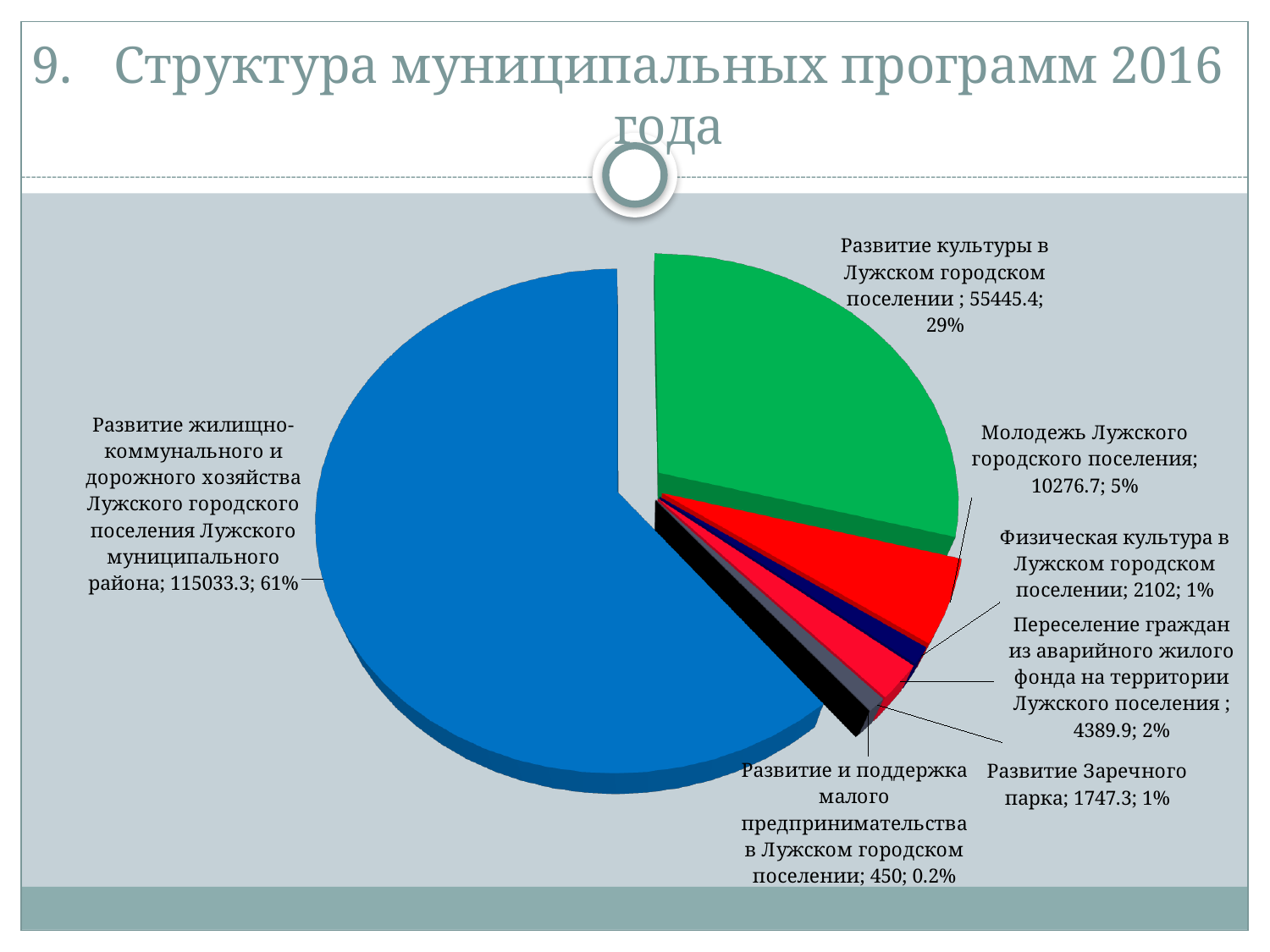
What kind of chart is shown on the slide? Pie chart What is the value for "Физическая культура в Лужском городском поселении"? 2102 What is the value for "Развитие Заречного парка"? 1747.3 Which program has the largest slice of the pie? Развитие жилищно-коммунального и дорожного хозяйства Лужского городского поселения Лужского муниципального района What share of the pie does "Развитие жилищно-коммунального и дорожного хозяйства" represent? 61% What is the value for "Развитие культуры в Лужском городском поселении"? 55445.4 Which is larger: the value for "Молодежь Лужского городского поселения" or for "Переселение граждан из аварийного жилого фонда"? Молодежь Лужского городского поселения What is the difference between the values for "Переселение граждан из аварийного жилого фонда" and "Физическая культура в Лужском городском поселении"? 2287.9 What is the title of the slide containing the chart? Структура муниципальных программ 2016 года What share of the pie does "Молодежь Лужского городского поселения" represent? 5% How many slices does the pie chart have? 7 Which program has the smallest slice of the pie? Развитие и поддержка малого предпринимательства в Лужском городском поселении